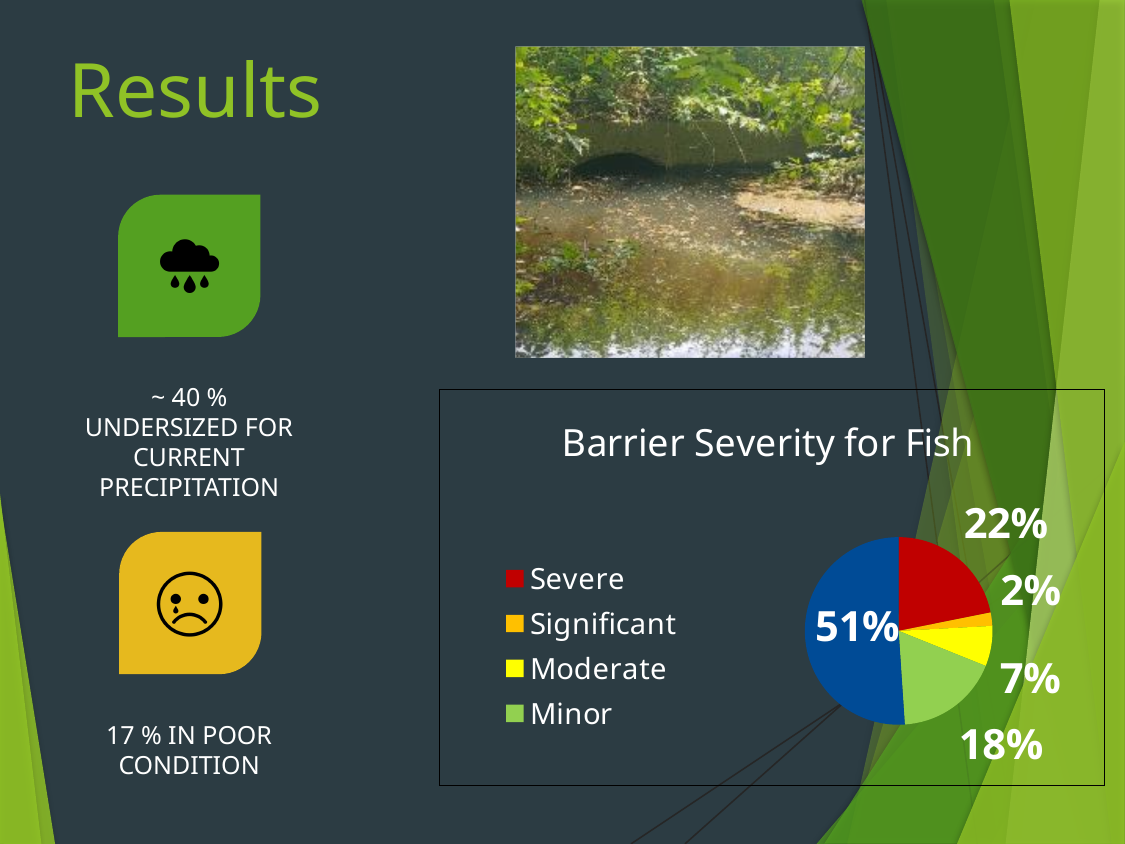
In the Barrier Severity for Fish chart, what percentage is labelled for the Minor slice? 18% In the Barrier Severity for Fish chart, what is the difference in percentage points between the Severe slice and the Minor slice? 4 What type of chart is shown under the title "Barrier Severity for Fish"? pie chart In the Barrier Severity for Fish chart, what is the largest percentage shown on any slice? 51% What is the title of the chart on the slide? Barrier Severity for Fish In the Barrier Severity for Fish chart, which legend category has the smallest slice? Significant How many slices does the Barrier Severity for Fish pie chart have? 5 In the Barrier Severity for Fish chart, what percentage is labelled for the Significant slice? 2% In the Barrier Severity for Fish chart, which slice is larger, Severe or Minor? Severe How many entries does the legend of the Barrier Severity for Fish chart list? 4 In the Barrier Severity for Fish chart, what percentage is labelled for the Severe slice? 22% In the Barrier Severity for Fish chart, what percentage is labelled for the Moderate slice? 7%